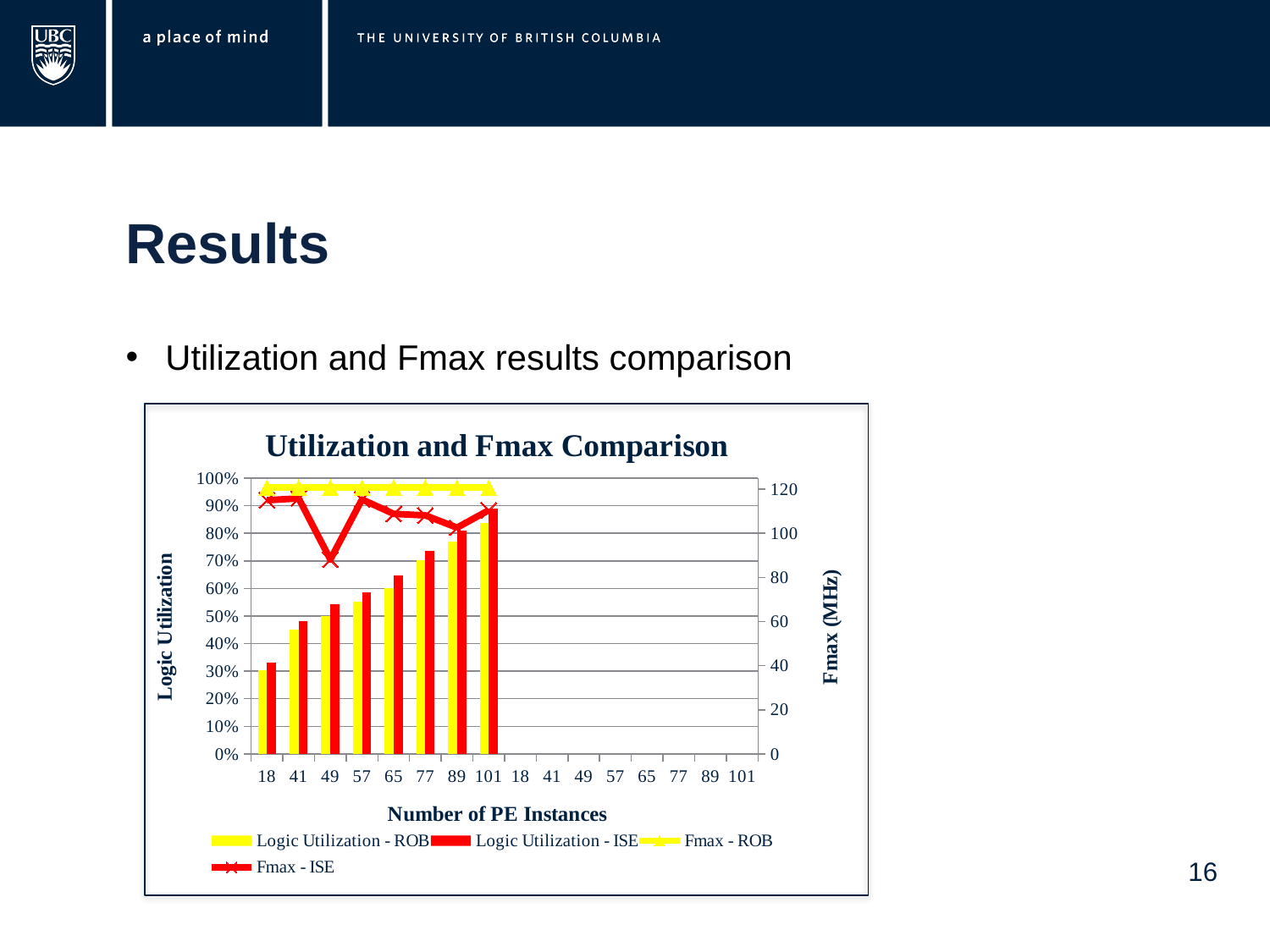
At 101 PE instances, which is larger: 'Logic Utilization - ROB' or 'Logic Utilization - ISE'? Logic Utilization - ISE Is the 'Fmax - ISE' value at 49 PE instances greater or less than 100 MHz? less Do the 'Logic Utilization - ISE' bars rise or fall as the number of PE instances increases from 18 to 101? Rise What is the title of the x axis of the chart? Number of PE Instances At which number of PE instances is the 'Logic Utilization - ISE' bar highest? 101 Is the 'Logic Utilization - ROB' value at 18 PE instances greater or less than 40%? less Is the 'Logic Utilization - ROB' value at 65 PE instances greater or less than 50%? greater How many series does the legend of the 'Utilization and Fmax Comparison' chart list? 4 At which number of PE instances is the 'Fmax - ISE' value lowest? 49 What kind of chart is 'Utilization and Fmax Comparison'? A combined bar and line chart How many bars are plotted for the 'Logic Utilization - ISE' series? 8